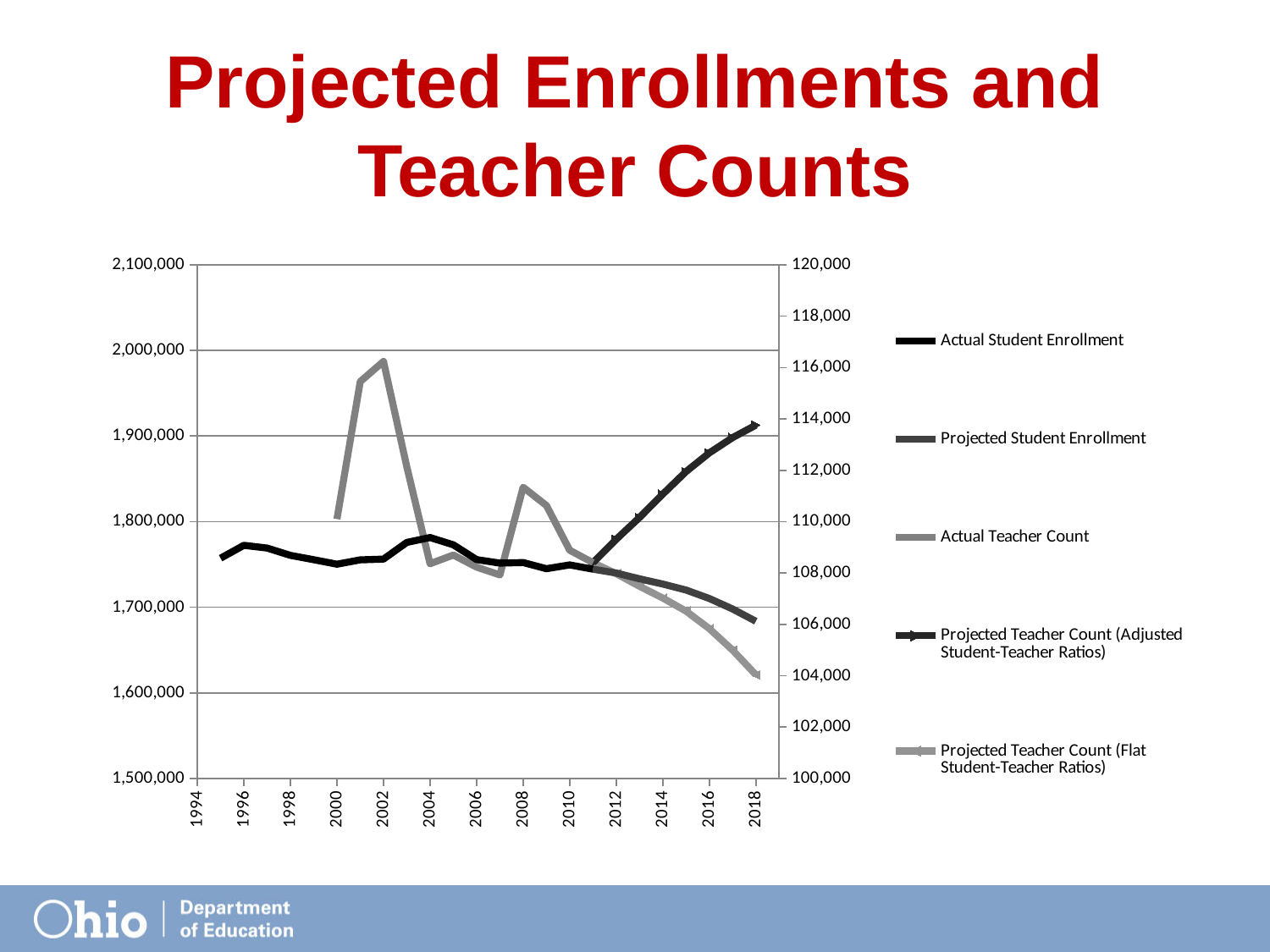
Is the Projected Teacher Count (Flat Student-Teacher Ratios) in 2018 greater or less than 106,000? less In which year does the Actual Teacher Count reach its highest value? 2002 Is the Actual Teacher Count in 2002 greater or less than 114,000? greater What is the title of the slide containing the chart? Projected Enrollments and Teacher Counts Is the Projected Student Enrollment in 2018 greater or less than 1,700,000? less What kind of chart is shown on the slide? line chart How many series does the legend list? 5 What is the highest value shown on the right-hand vertical axis? 120,000 Does the Projected Teacher Count (Adjusted Student-Teacher Ratios) rise or fall from 2012 to 2018? rise In 2018, which is higher: the Projected Teacher Count (Adjusted Student-Teacher Ratios) or the Projected Teacher Count (Flat Student-Teacher Ratios)? Projected Teacher Count (Adjusted Student-Teacher Ratios) Does the Projected Teacher Count (Flat Student-Teacher Ratios) rise or fall from 2012 to 2018? fall